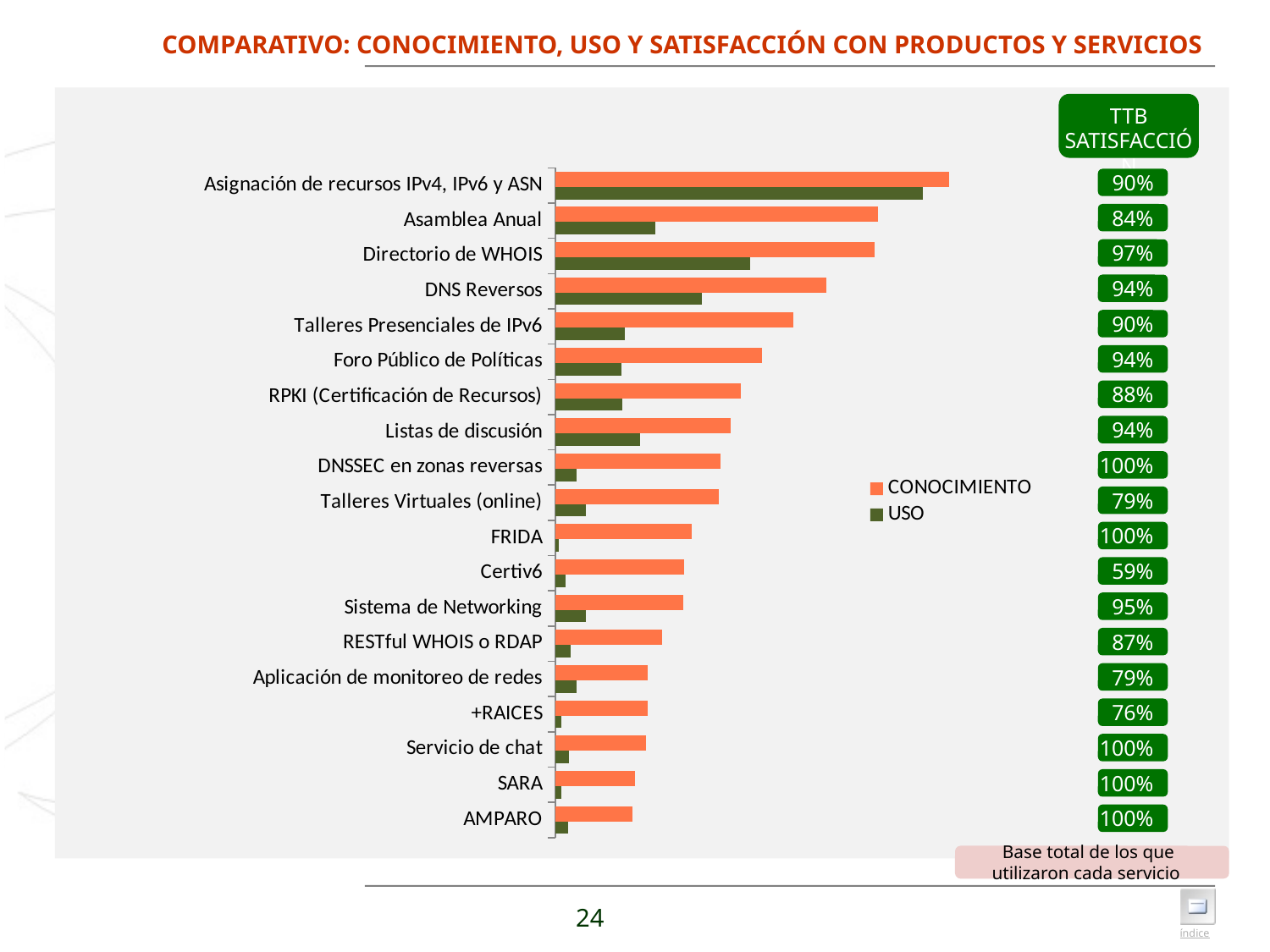
Which category has the highest CONOCIMIENTO value? Asignación de recursos IPv4, IPv6 y ASN Which category has the lowest TTB SATISFACCIÓN value? Certiv6 Which category has the highest USO value? Asignación de recursos IPv4, IPv6 y ASN Do the CONOCIMIENTO values rise or fall going down the list of categories from top to bottom? fall What kind of chart is shown on the slide? bar chart How many series does the legend list? 2 Which is larger, the USO value for Directorio de WHOIS or for Asamblea Anual? Directorio de WHOIS What is the TTB SATISFACCIÓN value shown for Certiv6? 59% How many products/services (categories) are shown in the chart? 19 Which is larger, the CONOCIMIENTO value for Asamblea Anual or for DNS Reversos? Asamblea Anual What is the TTB SATISFACCIÓN value shown for Directorio de WHOIS? 97% What is the difference between the TTB SATISFACCIÓN values for Directorio de WHOIS and Certiv6? 38 percentage points